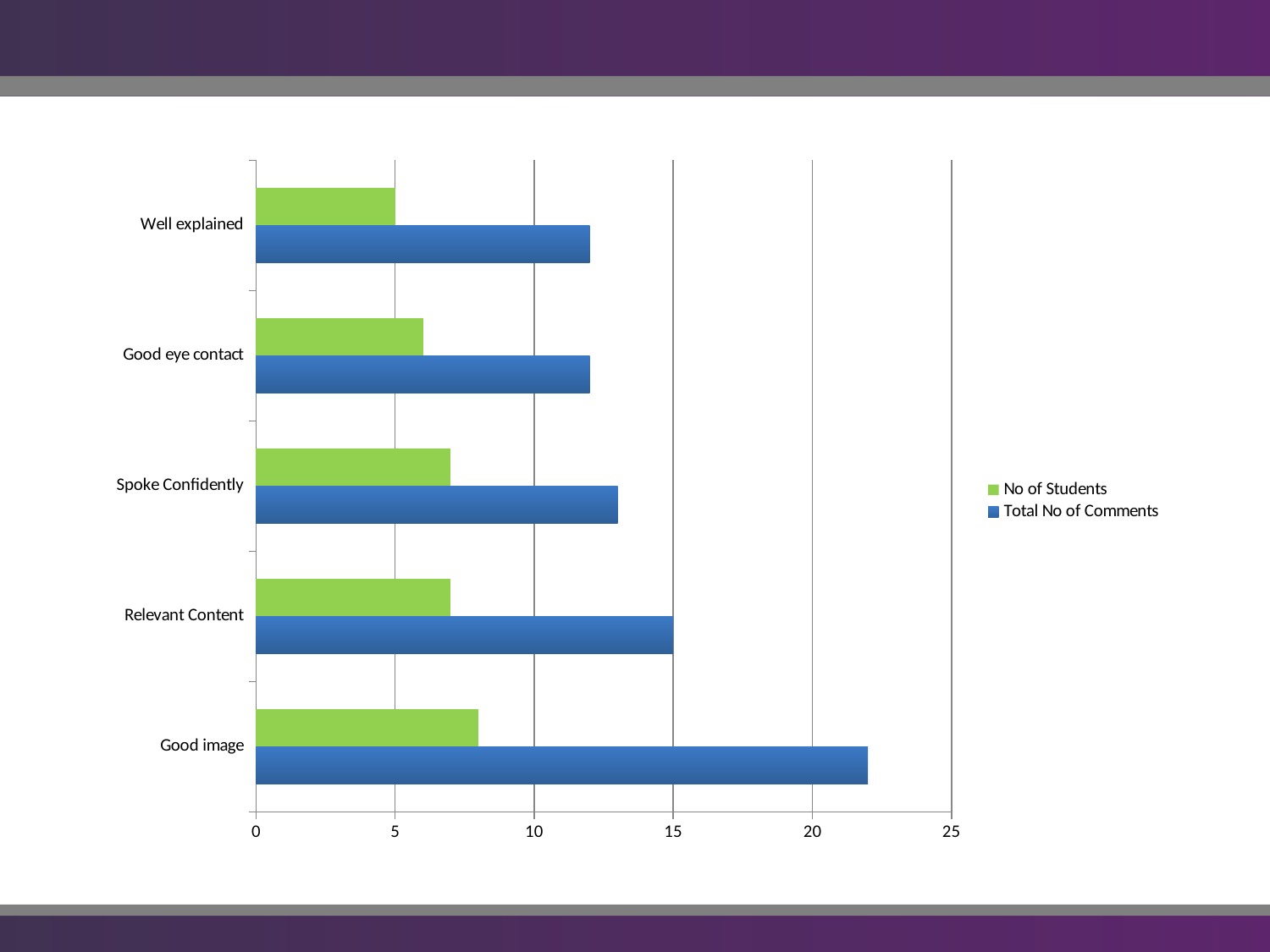
How many series does the legend list? 2 How many categories are shown on the chart? 5 Is the value of No of Students for Good image greater or less than 10? less Which is larger for Good image: No of Students or Total No of Comments? Total No of Comments Which category has the highest Total No of Comments? Good image What is the value of No of Students for Well explained? 5 What kind of chart is shown on the slide? bar chart Which category has the lowest No of Students? Well explained Which colour represents the No of Students series? green What is the value of Total No of Comments for Relevant Content? 15 Is the value of Total No of Comments for Spoke Confidently greater or less than 10? greater Is the value of Total No of Comments for Good image greater or less than 20? greater